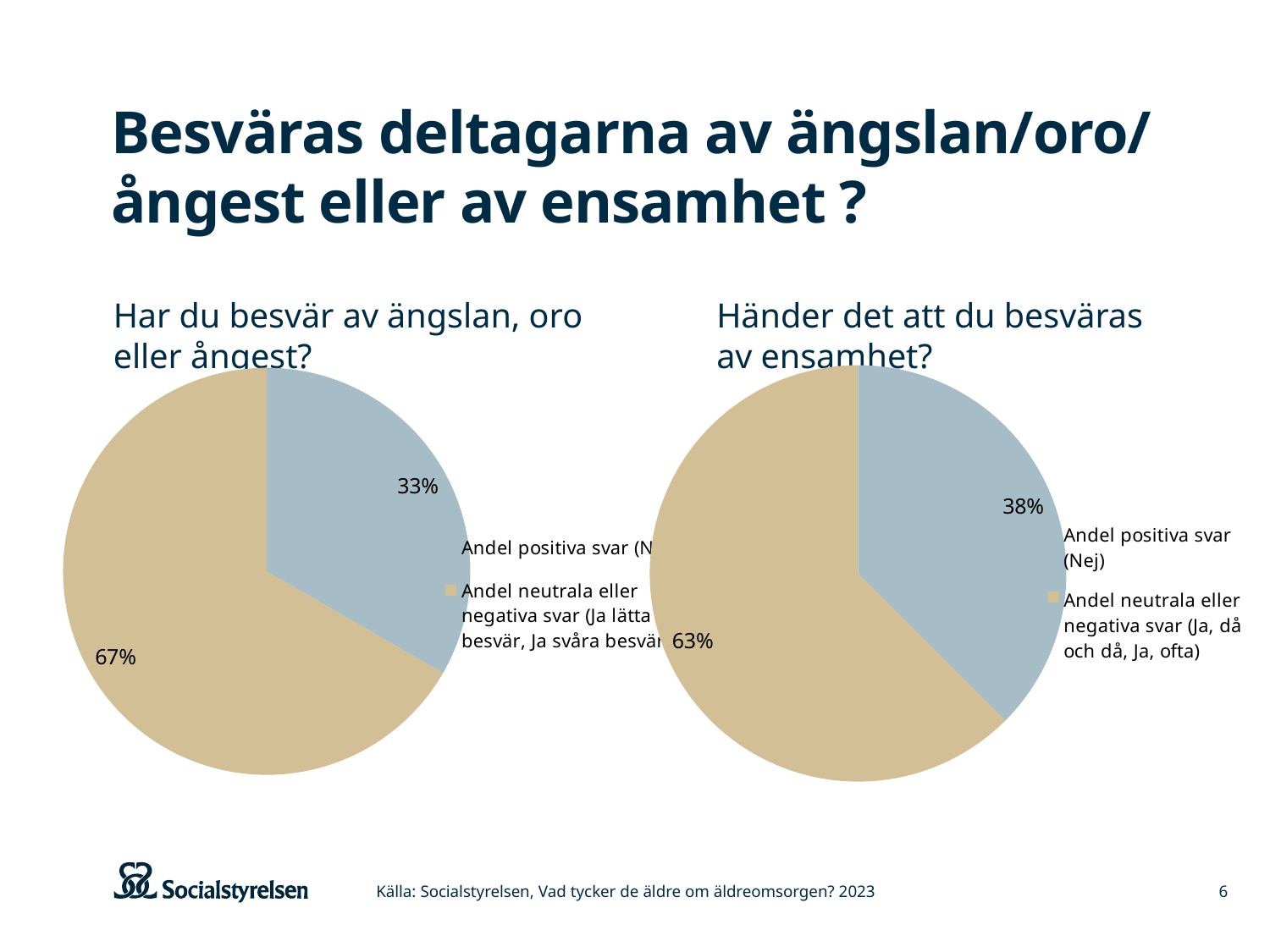
Which is larger: the share of positive answers in the left chart (ängslan, oro eller ångest) or in the right chart (ensamhet)? The right chart (ensamhet), 38% In the left chart 'Har du besvär av ängslan, oro eller ångest?', what share is labelled for the blue slice (Andel positiva svar)? 33% How many slices does each pie chart on the slide have? 2 In the right chart 'Händer det att du besväras av ensamhet?', what share is labelled for Andel positiva svar (Nej)? 38% In the right chart 'Händer det att du besväras av ensamhet?', which slice is the smallest? Andel positiva svar (Nej) (38%) In the right chart 'Händer det att du besväras av ensamhet?', what share is labelled for Andel neutrala eller negativa svar (Ja, då och då, Ja, ofta)? 63% In the left chart 'Har du besvär av ängslan, oro eller ångest?', what share is labelled for the tan slice (Andel neutrala eller negativa svar)? 67% In the left chart 'Har du besvär av ängslan, oro eller ångest?', what is the difference in percentage points between the two slices? 34 percentage points How many pie charts are on the slide? 2 What kind of chart is used on this slide? Pie chart How many entries does the legend of the right chart 'Händer det att du besväras av ensamhet?' list? 2 In the left chart 'Har du besvär av ängslan, oro eller ångest?', which slice is the largest? Andel neutrala eller negativa svar (67%)